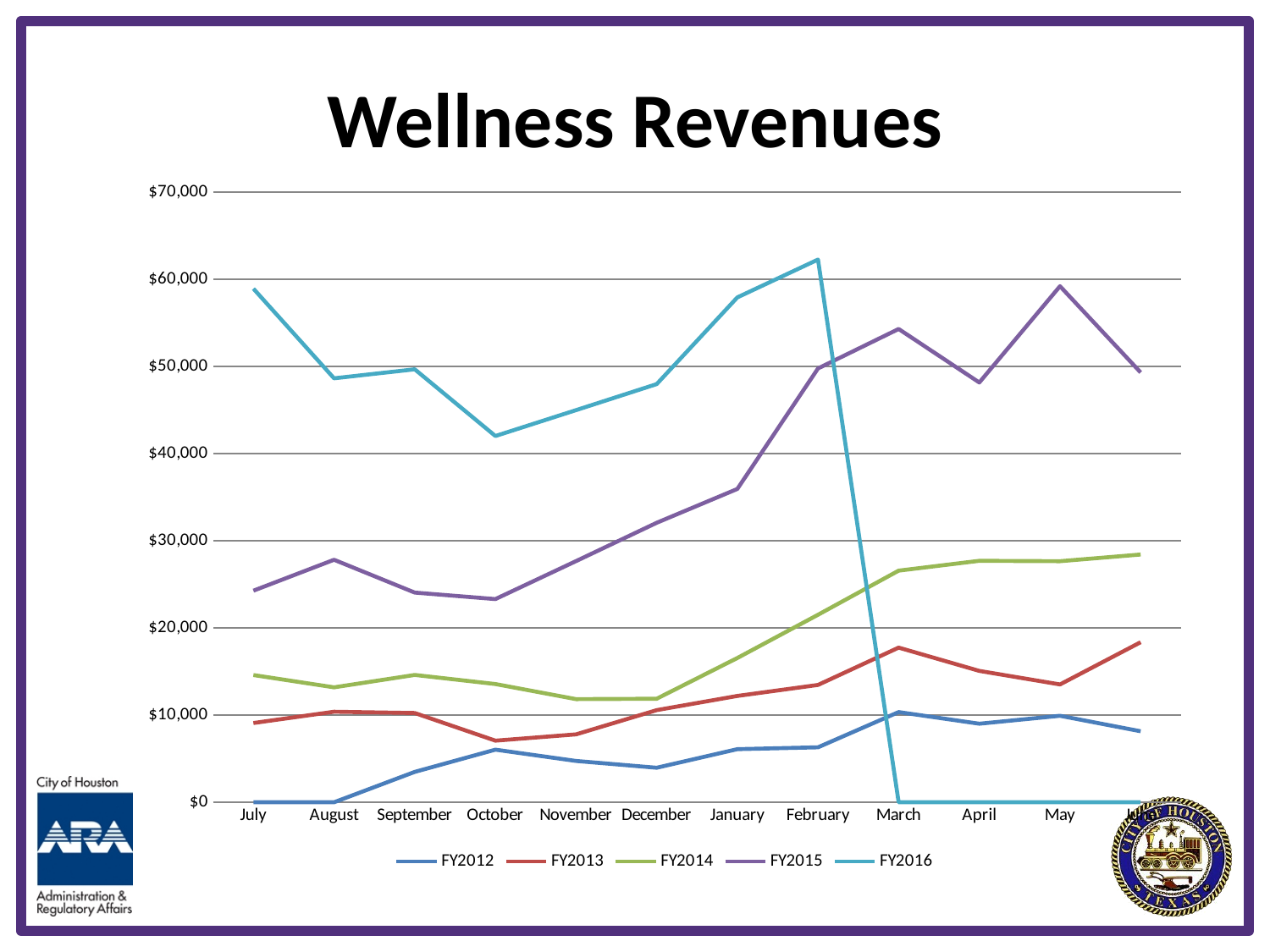
What is the FY2016 value for April? $0 What kind of chart is shown on the slide? line chart In which month does the FY2016 line reach its highest value? February In January, which is larger: the FY2014 value or the FY2013 value? FY2014 Is the FY2016 value for July greater or less than $50,000? greater Is the FY2014 value for March greater or less than $20,000? greater What is the title of the chart? Wellness Revenues How many series does the legend list? 5 In which month does the FY2015 line reach its highest value? May Which series is lowest in December? FY2012 Which series is highest in July? FY2016 Is the FY2013 value for October greater or less than $10,000? less